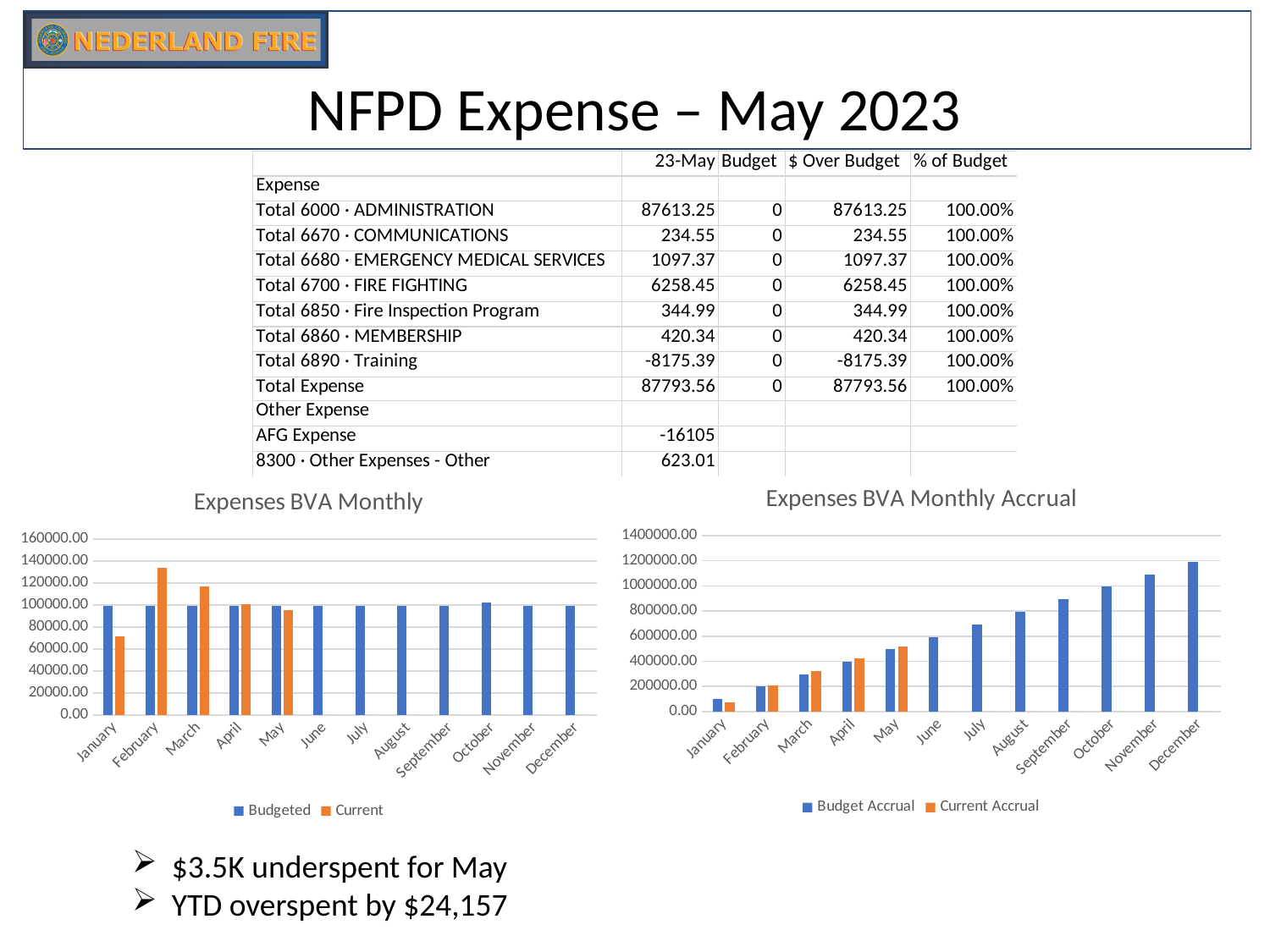
How many series does the legend of the "Expenses BVA Monthly" chart list? 2 In the "Expenses BVA Monthly Accrual" chart, how many months have a Current Accrual bar? 5 In the "Expenses BVA Monthly" chart, which month has the highest Current value? February How many months are shown on the x axis of the "Expenses BVA Monthly" chart? 12 In the "Expenses BVA Monthly" chart, which is larger for February: Budgeted or Current? Current In the "Expenses BVA Monthly" chart, is the Current value for January greater or less than 80000.00? less In the "Expenses BVA Monthly" chart, is the Current value for February greater or less than 120000.00? greater What kind of chart is the "Expenses BVA Monthly" chart on the left? Bar chart In the "Expenses BVA Monthly Accrual" chart, is the Budget Accrual value for December greater or less than 1000000.00? greater In the "Expenses BVA Monthly" chart, which month has the lowest Current value among the months with a Current bar? January In the "Expenses BVA Monthly Accrual" chart, do the Budget Accrual values rise or fall from January to December? Rise What are the two legend entries of the "Expenses BVA Monthly" chart? Budgeted and Current